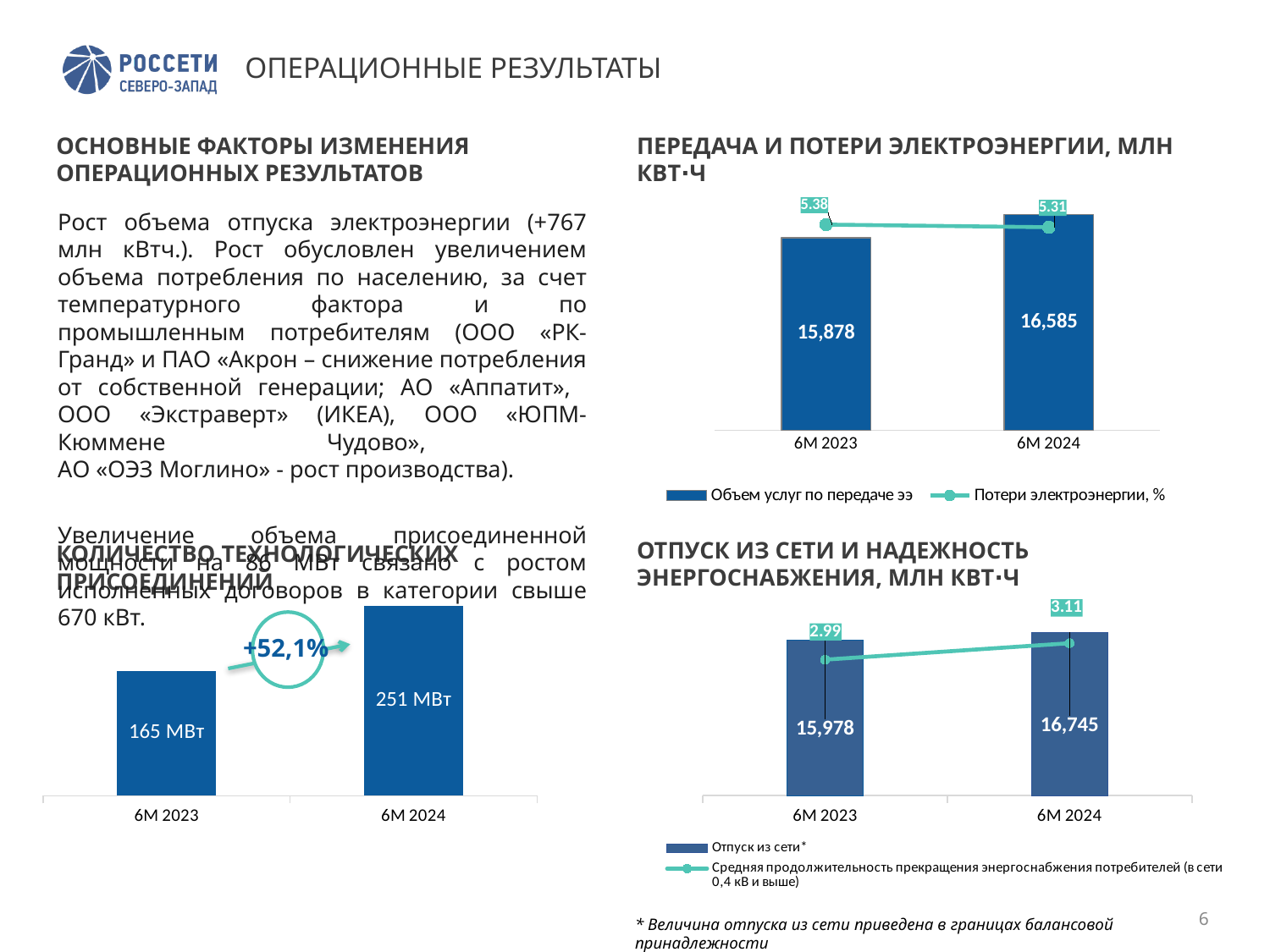
In the chart 'ПЕРЕДАЧА И ПОТЕРИ ЭЛЕКТРОЭНЕРГИИ, МЛН КВТ·Ч', does 'Потери электроэнергии, %' rise or fall from 6M 2023 to 6M 2024? fall In the chart 'ПЕРЕДАЧА И ПОТЕРИ ЭЛЕКТРОЭНЕРГИИ, МЛН КВТ·Ч', what is the value of 'Потери электроэнергии, %' for 6M 2023? 5.38 In the chart 'ПЕРЕДАЧА И ПОТЕРИ ЭЛЕКТРОЭНЕРГИИ, МЛН КВТ·Ч', what is the value of 'Объем услуг по передаче ээ' for 6M 2024? 16,585 How many series does the legend of the chart 'ПЕРЕДАЧА И ПОТЕРИ ЭЛЕКТРОЭНЕРГИИ, МЛН КВТ·Ч' list? 2 In the chart 'ОТПУСК ИЗ СЕТИ И НАДЕЖНОСТЬ ЭНЕРГОСНАБЖЕНИЯ, МЛН КВТ·Ч', what is the value of the line series for 6M 2024? 3.11 In the chart 'ПЕРЕДАЧА И ПОТЕРИ ЭЛЕКТРОЭНЕРГИИ, МЛН КВТ·Ч', by how much did 'Объем услуг по передаче ээ' change from 6M 2023 to 6M 2024? 707 In the bottom-left chart 'КОЛИЧЕСТВО ТЕХНОЛОГИЧЕСКИХ ПРИСОЕДИНЕНИЙ', what percentage change is shown between 6M 2023 and 6M 2024? +52,1% In the chart 'ОТПУСК ИЗ СЕТИ И НАДЕЖНОСТЬ ЭНЕРГОСНАБЖЕНИЯ, МЛН КВТ·Ч', what is the value of 'Отпуск из сети' for 6M 2023? 15,978 In the bottom-left chart 'КОЛИЧЕСТВО ТЕХНОЛОГИЧЕСКИХ ПРИСОЕДИНЕНИЙ', what is the difference between the 6M 2024 and 6M 2023 values? 86 МВт What kind of chart is the bottom-left chart 'КОЛИЧЕСТВО ТЕХНОЛОГИЧЕСКИХ ПРИСОЕДИНЕНИЙ'? bar chart In the bottom-left chart 'КОЛИЧЕСТВО ТЕХНОЛОГИЧЕСКИХ ПРИСОЕДИНЕНИЙ', what is the value for 6M 2023? 165 МВт In the chart 'ОТПУСК ИЗ СЕТИ И НАДЕЖНОСТЬ ЭНЕРГОСНАБЖЕНИЯ, МЛН КВТ·Ч', which period has the higher 'Отпуск из сети' value? 6M 2024